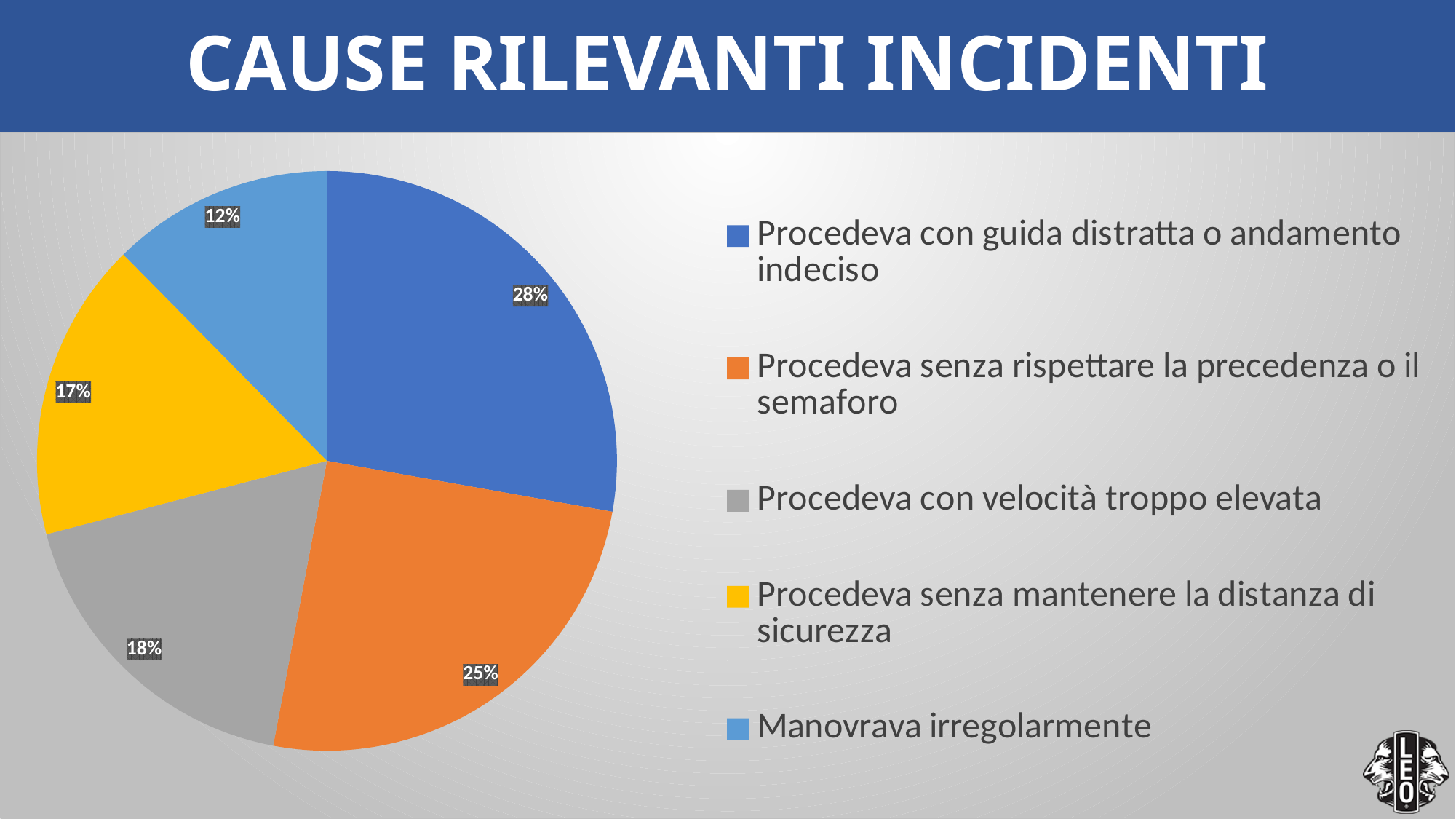
What is the difference in percentage points between "Procedeva con guida distratta o andamento indeciso" and "Manovrava irregolarmente"? 16 What kind of chart is shown on the slide? pie chart How many categories does the pie chart have? 5 What percentage is shown for "Manovrava irregolarmente"? 12% What percentage is shown for "Procedeva senza mantenere la distanza di sicurezza"? 17% What is the title of the slide containing the chart? CAUSE RILEVANTI INCIDENTI Which category has the smallest share of the pie? Manovrava irregolarmente Which is larger: the share for "Procedeva senza rispettare la precedenza o il semaforo" or for "Procedeva con velocità troppo elevata"? Procedeva senza rispettare la precedenza o il semaforo What percentage is shown for "Procedeva con velocità troppo elevata"? 18% What percentage is shown for "Procedeva con guida distratta o andamento indeciso"? 28% What percentage is shown for "Procedeva senza rispettare la precedenza o il semaforo"? 25% Which category has the largest share of the pie? Procedeva con guida distratta o andamento indeciso